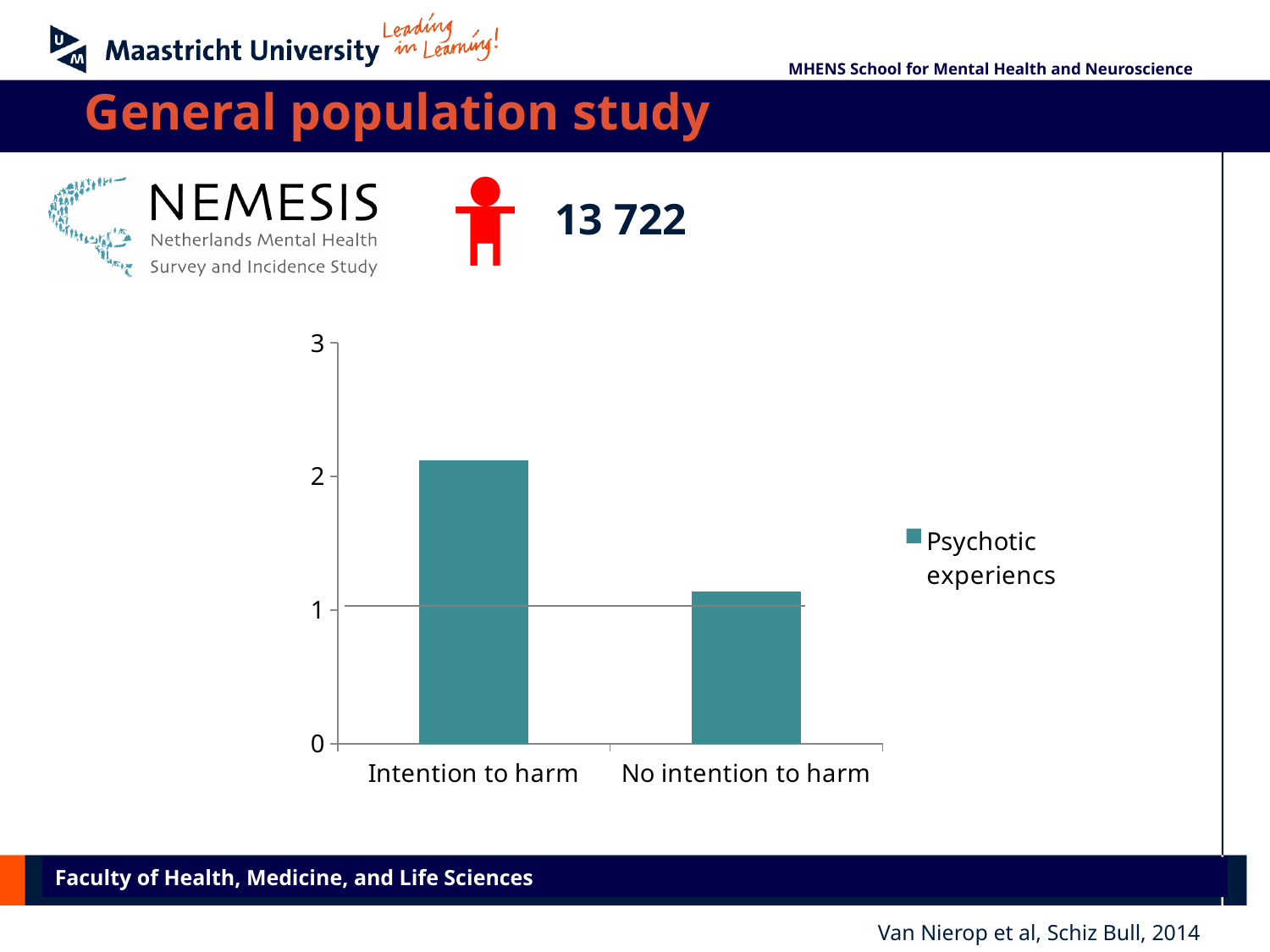
How many categories are shown on the x axis of the chart? 2 Which is larger, the value for Intention to harm or the value for No intention to harm? Intention to harm Which category has the highest bar in the chart? Intention to harm Is the value for Intention to harm greater or less than 2? greater Is the value for No intention to harm greater or less than 1? greater Which category has the lowest bar in the chart? No intention to harm What kind of chart is shown on the slide? bar chart Do the bar values rise or fall from left to right along the x axis? fall How many series does the chart's legend list? 1 What is the highest value shown on the chart's vertical axis? 3 Is the value for No intention to harm greater or less than 2? less What series name is shown in the chart's legend? Psychotic experiencs